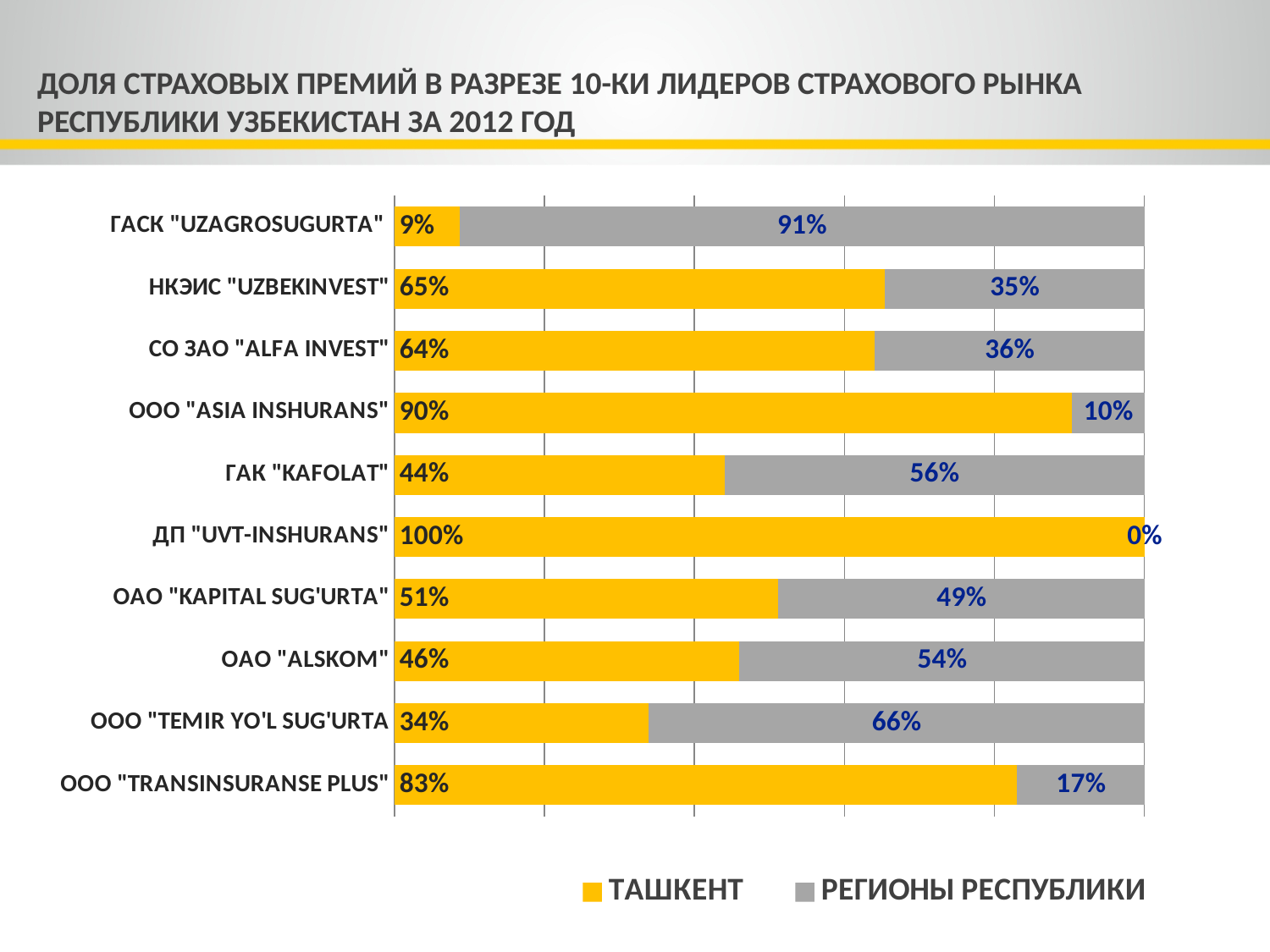
Which is larger: the ТАШКЕНТ share of НКЭИС "UZBEKINVEST" or of СО ЗАО "ALFA INVEST"? НКЭИС "UZBEKINVEST" Which colour represents ТАШКЕНТ in the chart? Yellow What is the difference between the ТАШКЕНТ share of ООО "ASIA INSHURANS" and that of ОАО "ALSKOM"? 44% What kind of chart is shown on the slide? Stacked bar chart What is the total of the two segments for ОАО "KAPITAL SUG'URTA"? 100% How many companies are shown in the chart? 10 What is the ТАШКЕНТ share for ООО "TRANSINSURANSE PLUS"? 83% What is the РЕГИОНЫ РЕСПУБЛИКИ share for ГАК "KAFOLAT"? 56% Which company has the lowest ТАШКЕНТ share? ГАСК "UZAGROSUGURTA" Which company has the highest ТАШКЕНТ share? ДП "UVT-INSHURANS" How many series does the legend list? 2 What is the ТАШКЕНТ share for ГАСК "UZAGROSUGURTA"? 9%